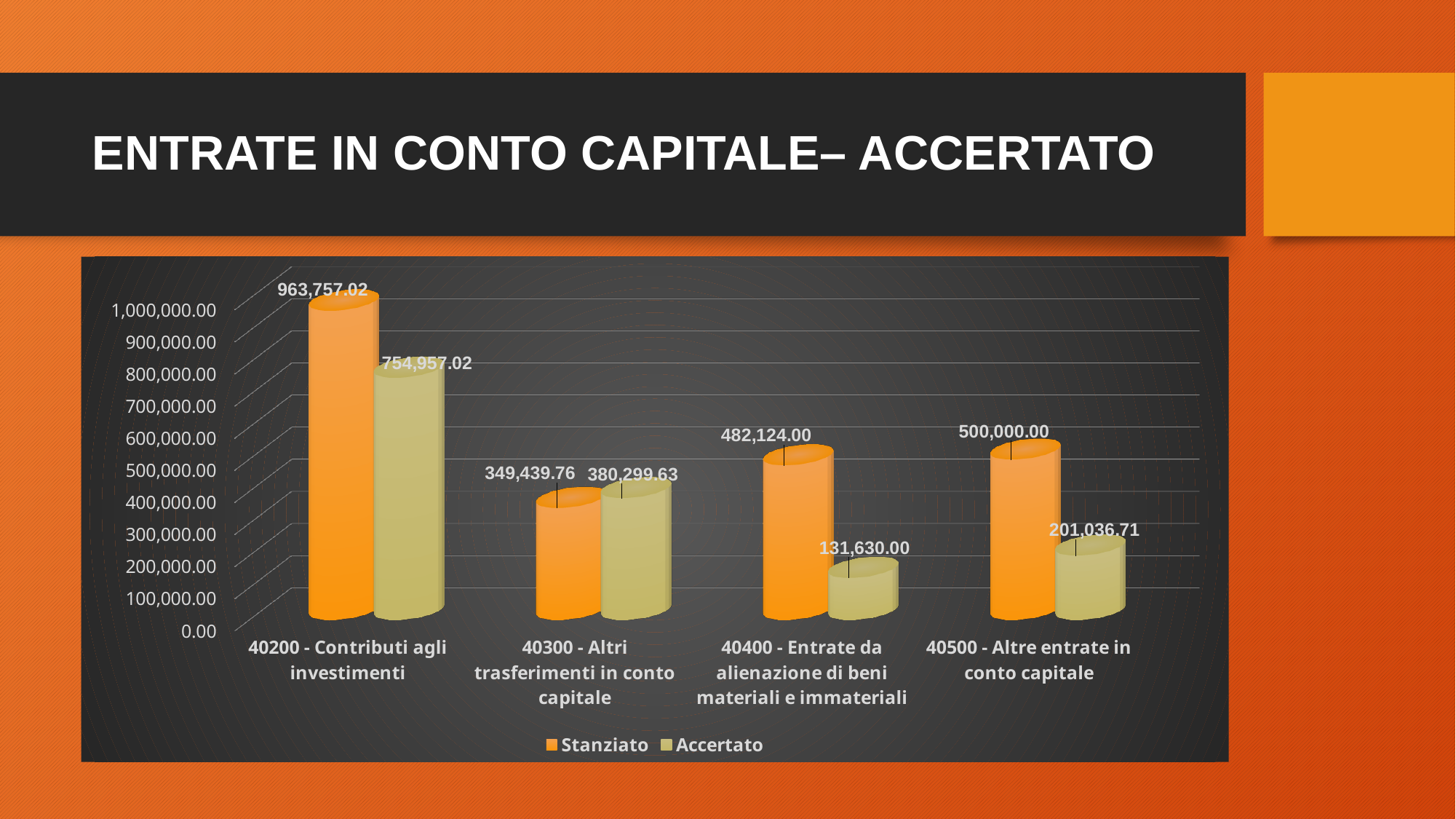
What is the difference between the Stanziato and Accertato values for 40500 - Altre entrate in conto capitale? 298,963.29 What is the Accertato value for 40300 - Altri trasferimenti in conto capitale? 380,299.63 What kind of chart is shown on the slide? Bar chart What is the Accertato value for 40400 - Entrate da alienazione di beni materiali e immateriali? 131,630.00 For 40300 - Altri trasferimenti in conto capitale, which is larger: Stanziato or Accertato? Accertato How many categories are shown on the x axis? 4 Which category has the highest Accertato value? 40200 - Contributi agli investimenti What is the difference between the Stanziato and Accertato values for 40200 - Contributi agli investimenti? 208,800.00 What is the Stanziato value for 40200 - Contributi agli investimenti? 963,757.02 Which category has the lowest Stanziato value? 40300 - Altri trasferimenti in conto capitale What is the Stanziato value for 40500 - Altre entrate in conto capitale? 500,000.00 How many series does the legend list? 2